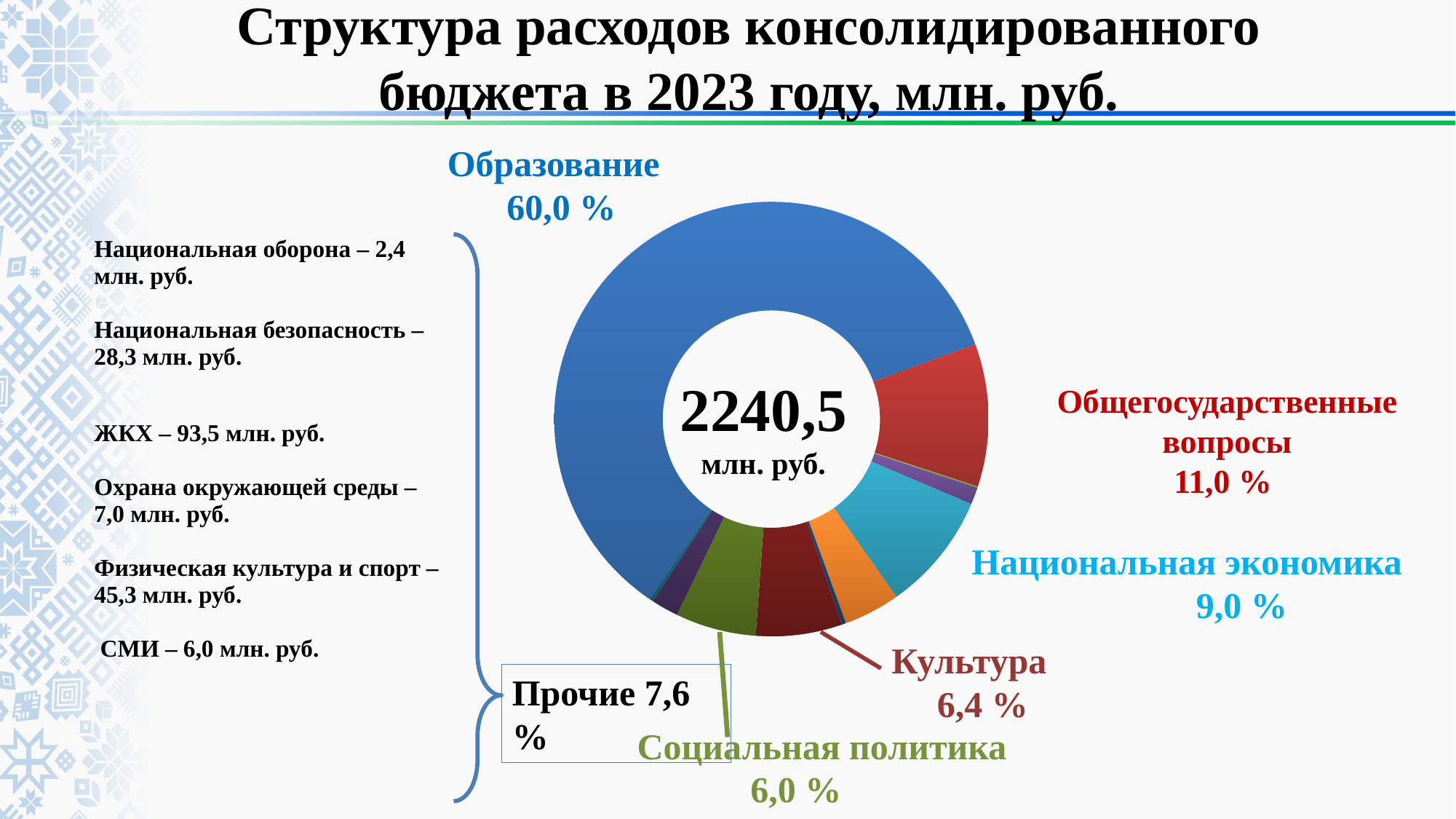
What share of expenditures does Образование account for in the donut chart? 60,0 % What share of expenditures does Национальная экономика account for? 9,0 % Which category has the largest share of expenditures in the chart? Образование What share of expenditures does Социальная политика account for? 6,0 % What total value is shown in the centre of the donut chart? 2240,5 млн. руб. What is the difference in share between Образование and Общегосударственные вопросы? 49,0 % What is the title of the slide containing the chart? Структура расходов консолидированного бюджета в 2023 году, млн. руб. Which of the labelled categories has the smallest share: Культура or Социальная политика? Социальная политика What kind of chart is shown on the slide? Donut (pie) chart